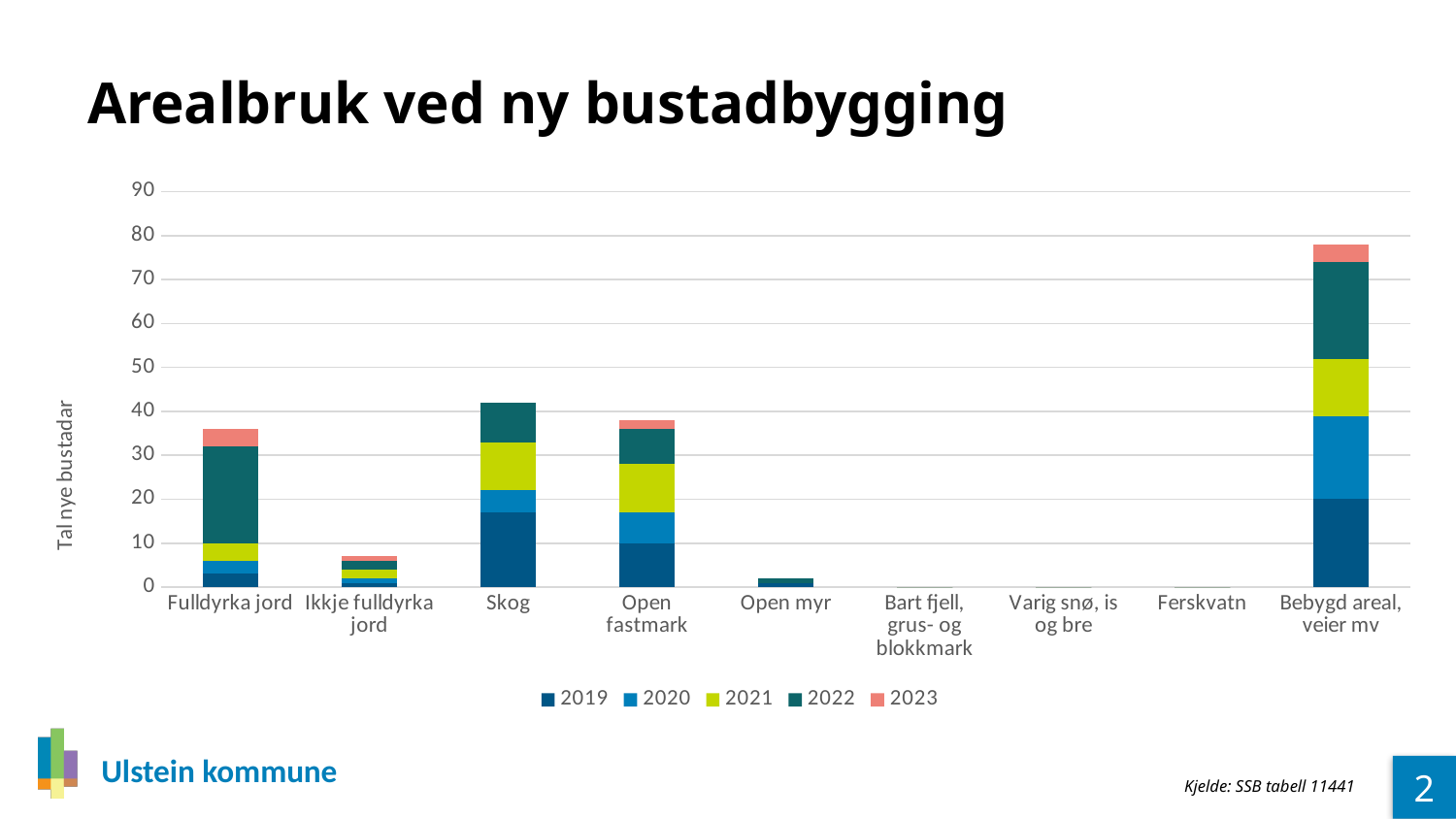
How many categories are shown on the x axis? 9 What is the title of the chart? Arealbruk ved ny bustadbygging Is the total for Skog greater or less than 30? greater What is the label on the y axis? Tal nye bustadar Is the total for Fulldyrka jord greater or less than 40? less Which category has the highest total stacked bar? Bebygd areal, veier mv Is the total for Bebygd areal, veier mv greater or less than 70? greater How many series does the legend list? 5 Which has the larger total, Skog or Fulldyrka jord? Skog Which has the larger total, Ikkje fulldyrka jord or Open myr? Ikkje fulldyrka jord What kind of chart is shown on the slide? Stacked bar chart